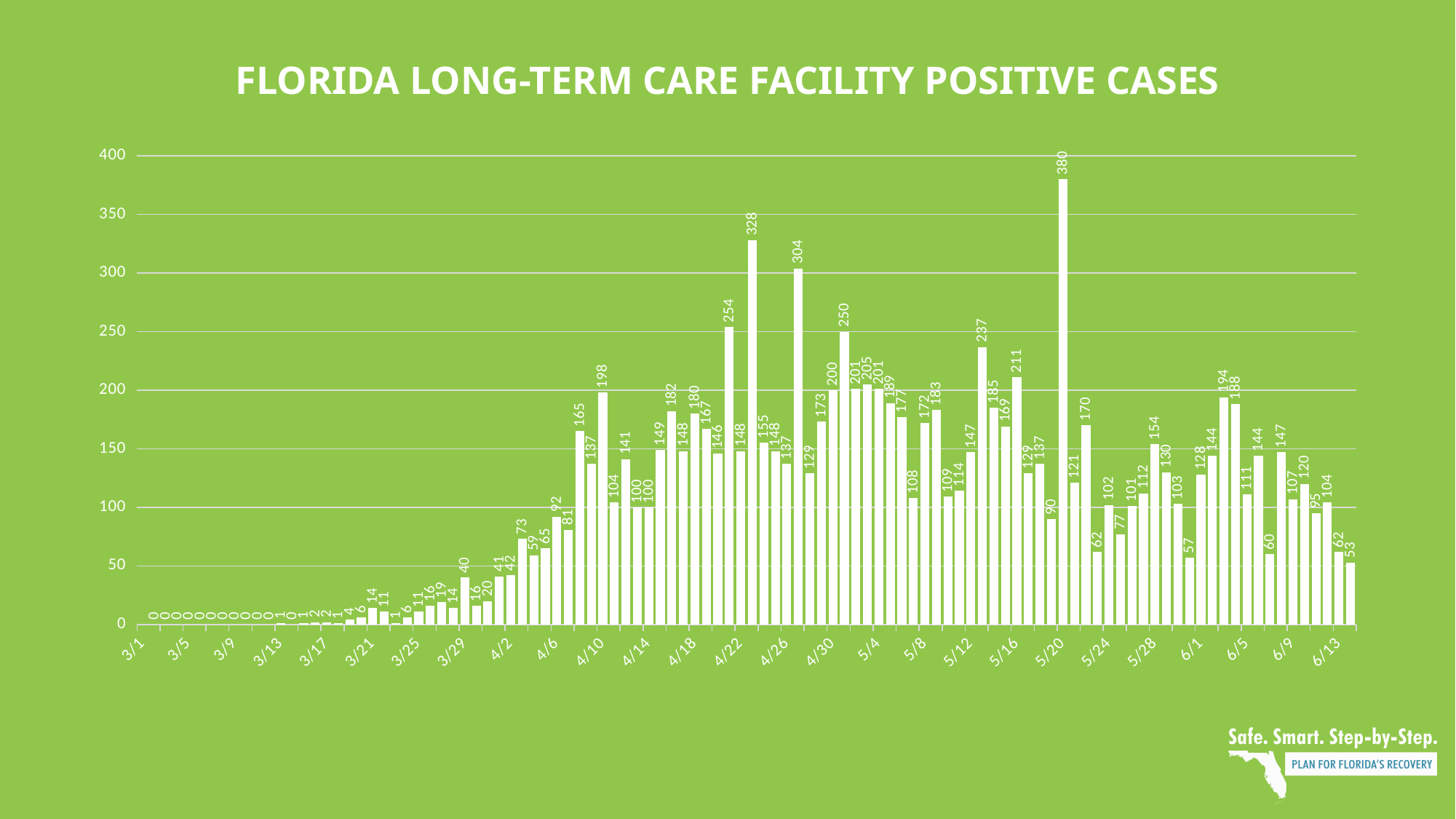
What is the maximum value shown on the vertical axis? 400 What is the title of the chart? FLORIDA LONG-TERM CARE FACILITY POSITIVE CASES What is the lowest value shown on the chart? 0 What kind of chart is shown on the slide? bar chart On which date does the chart show its highest value? 5/20 Is the value for 5/20 greater or less than 350? greater What is the difference between the highest bar (380) and the second-highest bar (328)? 52 Which is larger, the bar labeled 328 or the bar labeled 304? 328 What is the difference between the bar labeled 254 and the bar labeled 250? 4 What is the highest daily value shown in the chart? 380 What is the second-highest daily value labeled on the chart? 328 Do the values generally rise or fall from early March through mid-April? rise